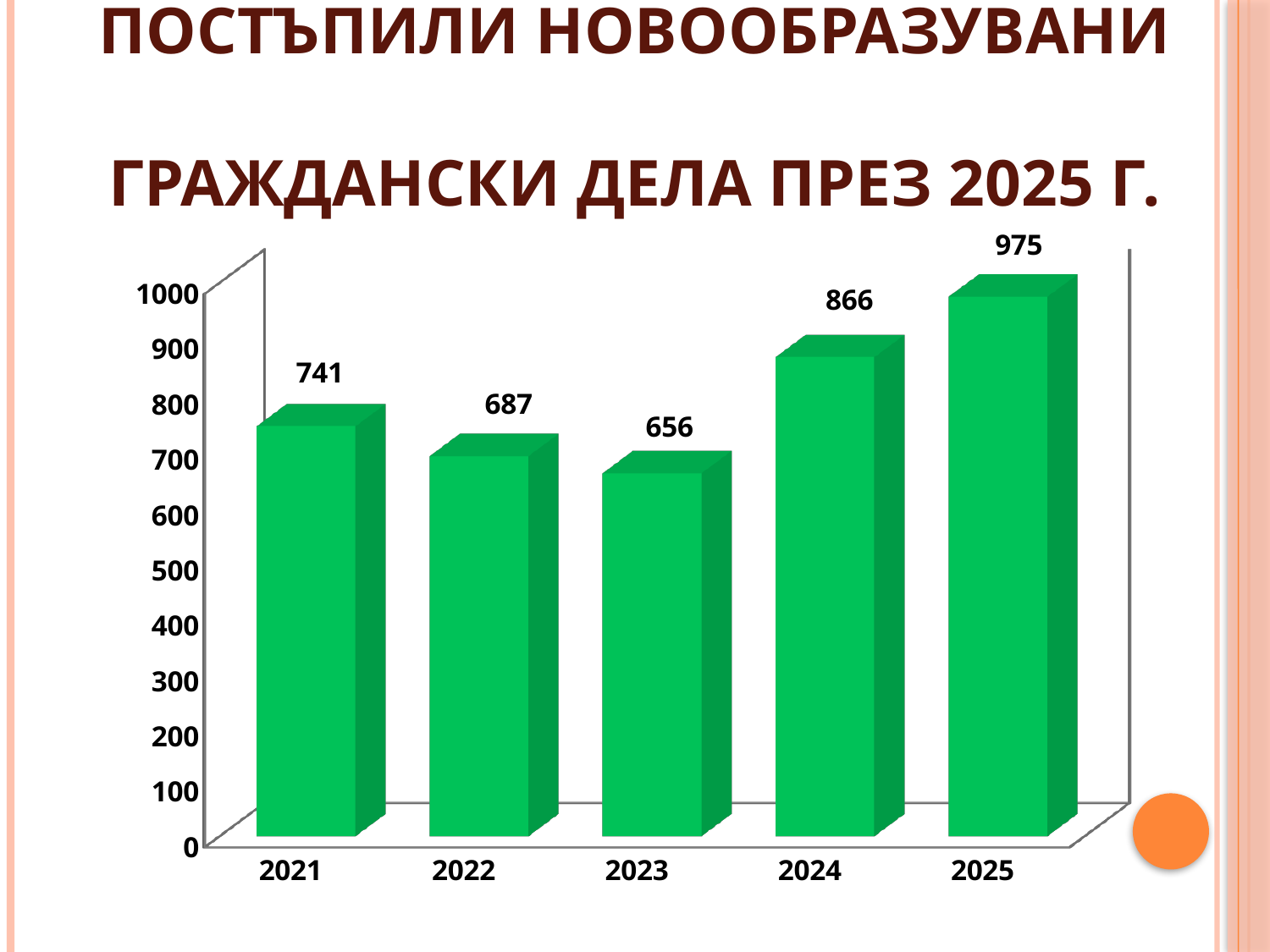
What kind of chart is shown on the slide? bar chart What is the value for 2021? 741 What is the value for 2023? 656 What is the difference between the values for 2025 and 2024? 109 What is the value for 2025? 975 Do the values rise or fall from 2023 to 2025? rise What is the difference between the values for 2021 and 2022? 54 How many years are shown on the x axis? 5 Which year has the highest value? 2025 Which year has the lowest value? 2023 Is the value for 2024 greater or less than 800? greater Which is larger, the value for 2022 or the value for 2024? 2024